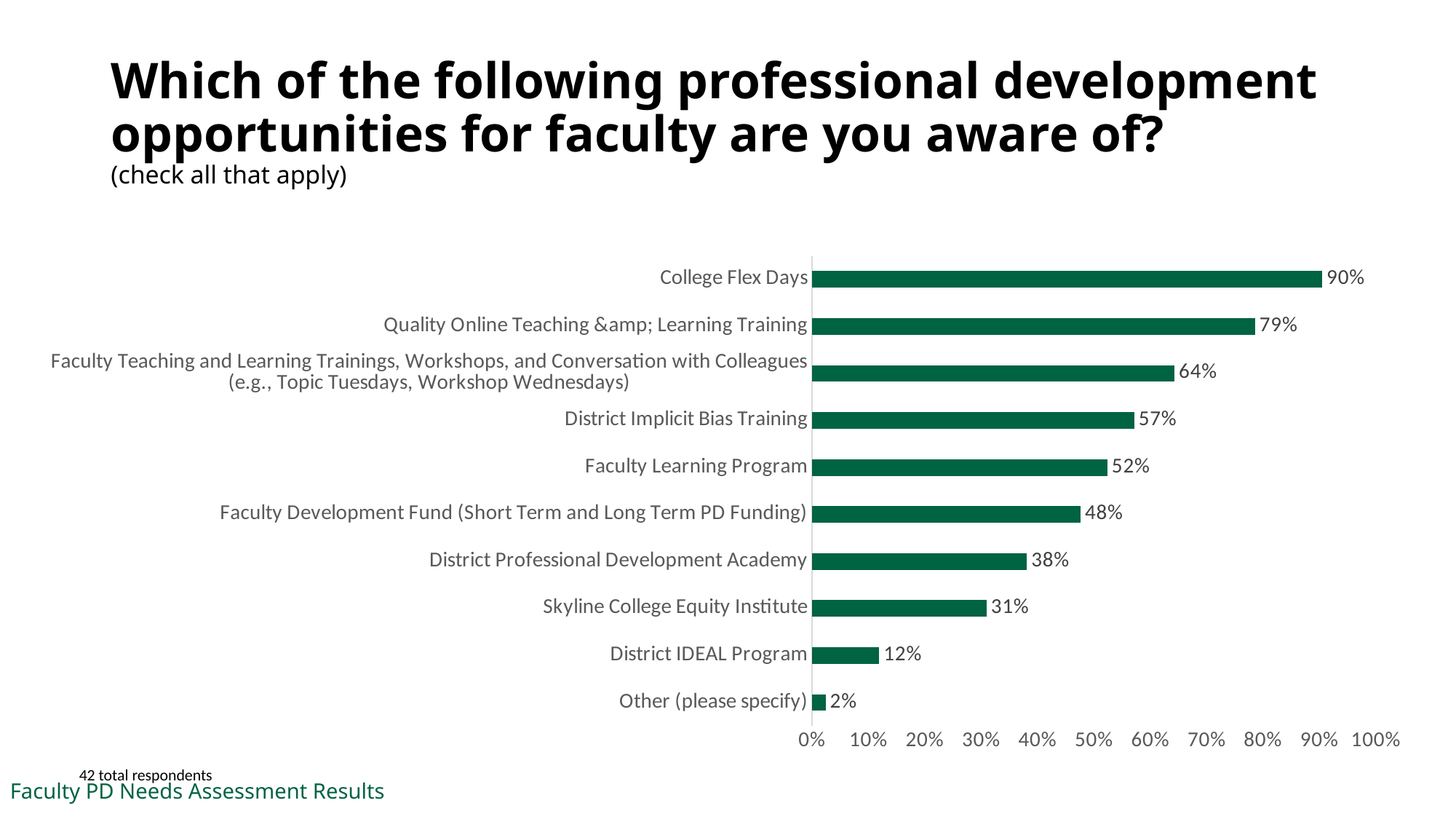
Which category has the lowest value in the chart? Other (please specify) What percentage of respondents are aware of the Skyline College Equity Institute? 31% What is the difference in percentage points between College Flex Days and Quality Online Teaching & Learning Training? 11% How many categories are shown in the chart? 10 How many total respondents does the slide report? 42 What percentage of respondents are aware of the District Implicit Bias Training? 57% Which professional development opportunity has the highest awareness? College Flex Days What percentage of respondents are aware of the District IDEAL Program? 12% What is the difference in percentage points between the Faculty Development Fund and the District IDEAL Program? 36% What type of chart is shown on the slide? Bar chart What percentage of respondents are aware of College Flex Days? 90% Which has a higher awareness percentage: Faculty Learning Program or District Professional Development Academy? Faculty Learning Program